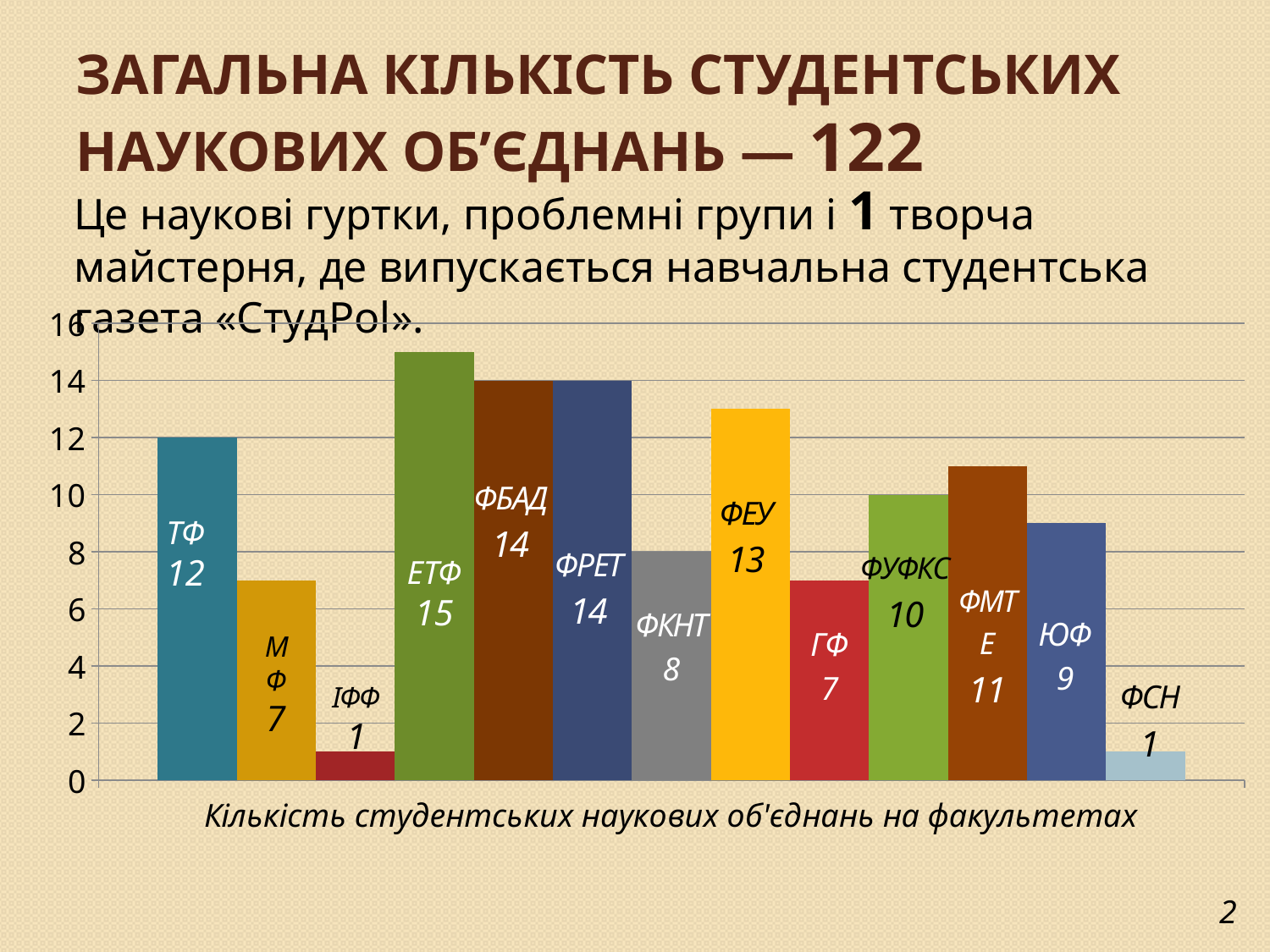
What is the difference between the values for ФЕУ and ЮФ? 4 How many faculties (bars) are shown in the chart? 13 What is the value for ФКНТ? 8 What kind of chart is shown on the slide? bar chart What is the caption shown below the chart? Кількість студентських наукових об'єднань на факультетах What is the value for ФЕУ? 13 What is the value for ЕТФ? 15 What is the difference between the values for ЕТФ and ТФ? 3 Which faculty has the highest value? ЕТФ Is the value for ФБАД greater or less than 10? greater What is the value for ФМТЕ? 11 Which is larger, the value for ФУФКС or the value for ГФ? ФУФКС